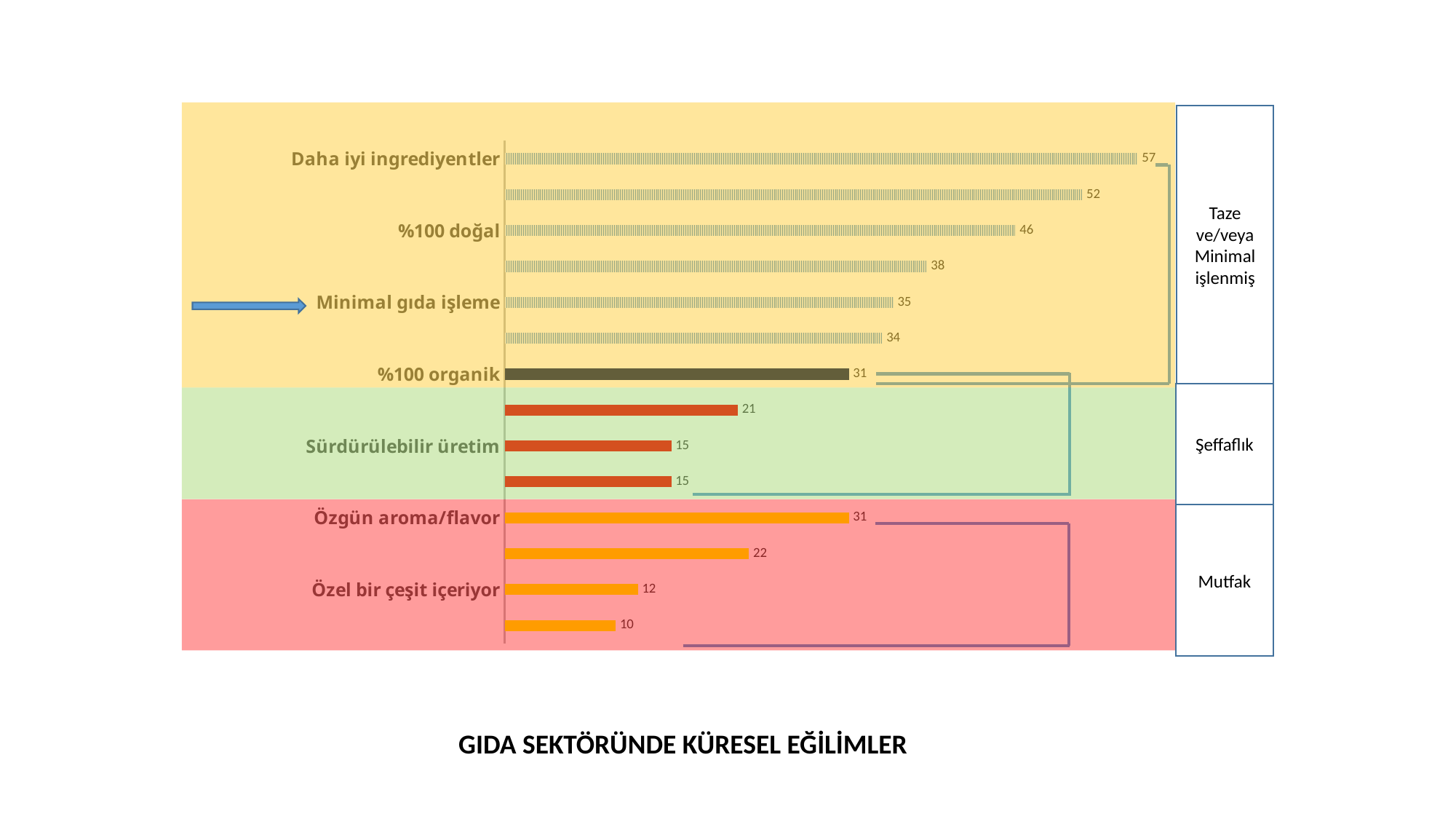
What is the value for Sürdürülebilir üretim? 15 What is the value for Minimal gıda işleme? 35 What is the smallest value shown on any bar in the chart? 10 What is the value for Daha iyi ingrediyentler? 57 Which is larger, the value for Minimal gıda işleme or the value for Özel bir çeşit içeriyor? Minimal gıda işleme What is the difference between the values for Daha iyi ingrediyentler and %100 doğal? 11 How many bars are plotted in the chart? 14 What kind of chart is shown on the slide? Bar chart What is the value for %100 organik? 31 What is the value for Özgün aroma/flavor? 31 What is the value for %100 doğal? 46 Which labelled category has the highest value? Daha iyi ingrediyentler